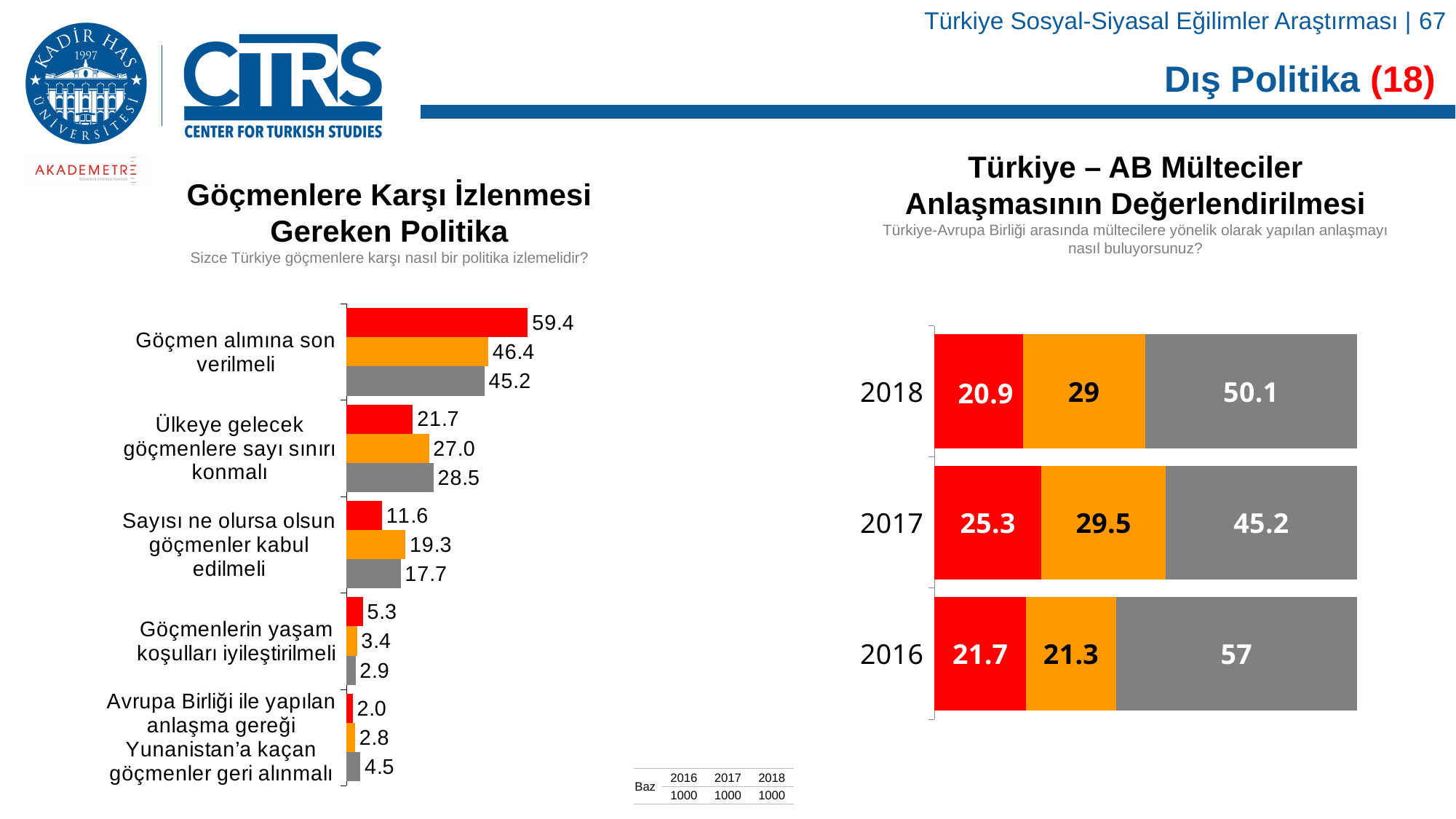
In the right chart 'Türkiye – AB Mülteciler Anlaşmasının Değerlendirilmesi', what is the value of the red segment for 2017? 25.3 In the left chart 'Göçmenlere Karşı İzlenmesi Gereken Politika', what is the difference between the red and orange bars for 'Göçmen alımına son verilmeli'? 13.0 In the right chart 'Türkiye – AB Mülteciler Anlaşmasının Değerlendirilmesi', what is the total of the 2018 bar? 100 In the right chart 'Türkiye – AB Mülteciler Anlaşmasının Değerlendirilmesi', which year has the largest grey segment? 2016 In the right chart 'Türkiye – AB Mülteciler Anlaşmasının Değerlendirilmesi', is the red segment larger for 2017 or 2018? 2017 In the left chart 'Göçmenlere Karşı İzlenmesi Gereken Politika', what is the value of the red bar for 'Göçmen alımına son verilmeli'? 59.4 What type of chart is the left chart 'Göçmenlere Karşı İzlenmesi Gereken Politika'? bar chart In the left chart 'Göçmenlere Karşı İzlenmesi Gereken Politika', how many categories are shown? 5 In the left chart 'Göçmenlere Karşı İzlenmesi Gereken Politika', what is the value of the grey bar for 'Ülkeye gelecek göçmenlere sayı sınırı konmalı'? 28.5 In the left chart 'Göçmenlere Karşı İzlenmesi Gereken Politika', which category has the highest red bar? Göçmen alımına son verilmeli In the right chart 'Türkiye – AB Mülteciler Anlaşmasının Değerlendirilmesi', what is the value of the grey segment for 2016? 57 In the left chart 'Göçmenlere Karşı İzlenmesi Gereken Politika', which category has the lowest orange bar? Avrupa Birliği ile yapılan anlaşma gereği Yunanistan'a kaçan göçmenler geri alınmalı